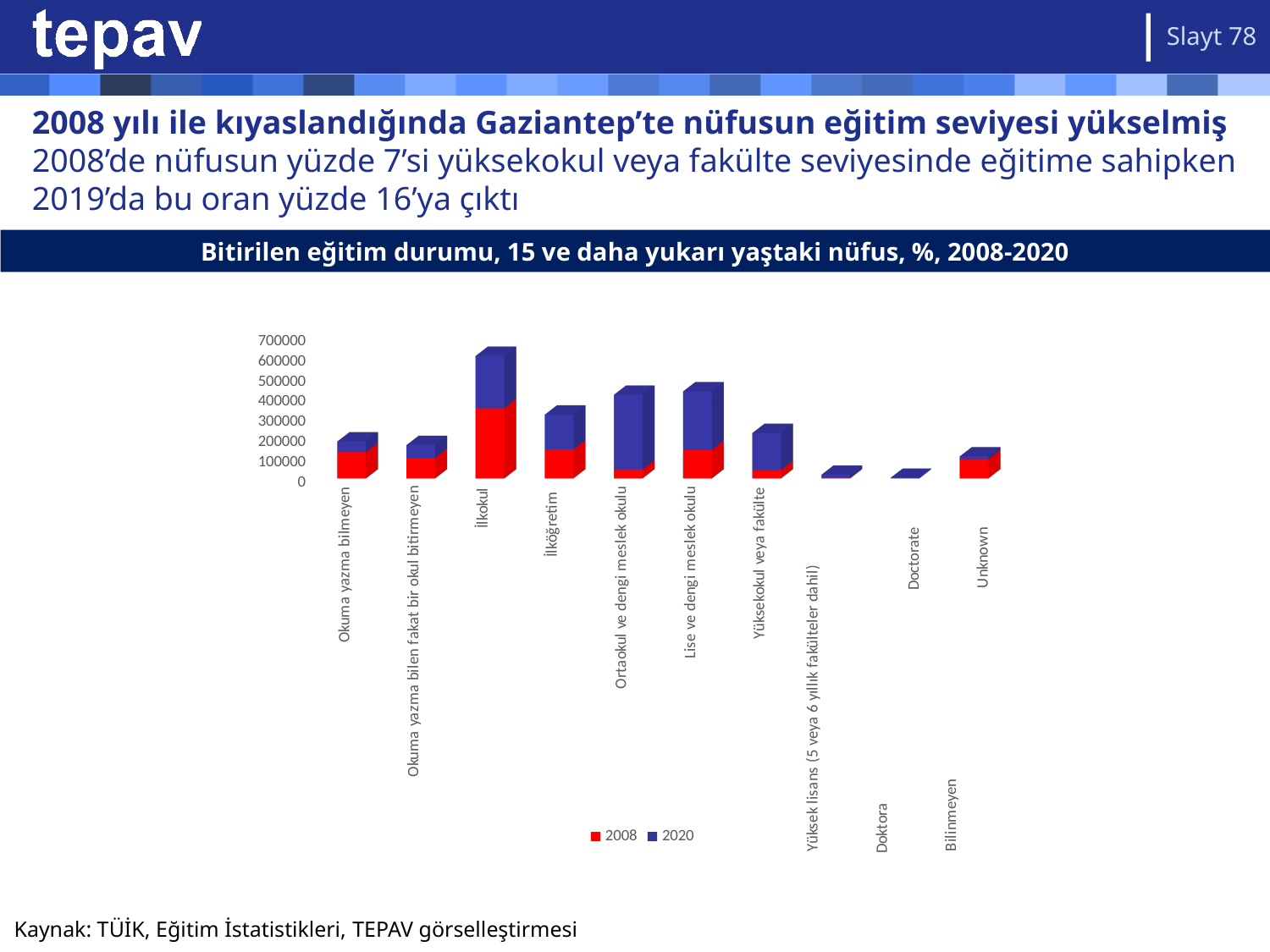
Which colour represents the 2008 series in the legend? Red Which category has the tallest stacked bar? İlkokul How many education categories are shown on the x axis? 10 Is the total stacked value for İlkokul greater or less than 500000? greater Which has the larger stacked bar, Lise ve dengi meslek okulu or Yüksekokul veya fakülte? Lise ve dengi meslek okulu Is the total stacked value for Okuma yazma bilmeyen greater or less than 300000? less How many series does the legend list? 2 What is the title of the chart? Bitirilen eğitim durumu, 15 ve daha yukarı yaştaki nüfus, %, 2008-2020 Is the total stacked value for Doktora greater or less than 100000? less What kind of chart is shown on the slide? Bar chart Which has the larger stacked bar, İlkokul or İlköğretim? İlkokul